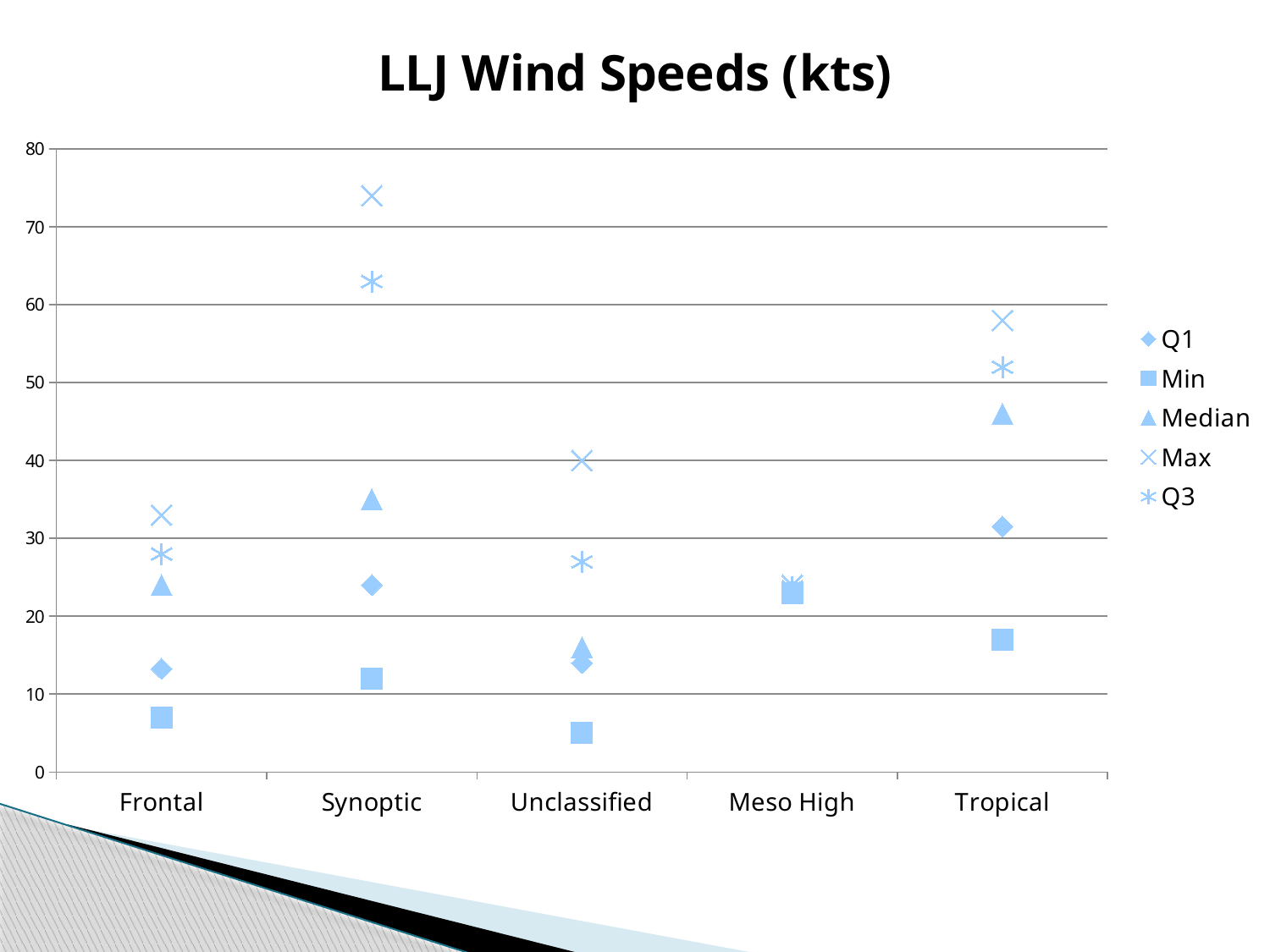
How many categories are shown on the x axis? 5 What is the title of the chart? LLJ Wind Speeds (kts) Is the Q3 value for Synoptic greater or less than 60? greater How many series does the legend list? 5 Which series is shown with an X marker in the legend? Max Which category has the highest Max value? Synoptic Is the Max value for Tropical greater or less than 60? less Which is larger, the Median value for Tropical or the Median value for Synoptic? Tropical Which category has the lowest Min value? Unclassified Is the Max value for Synoptic greater or less than 70? greater